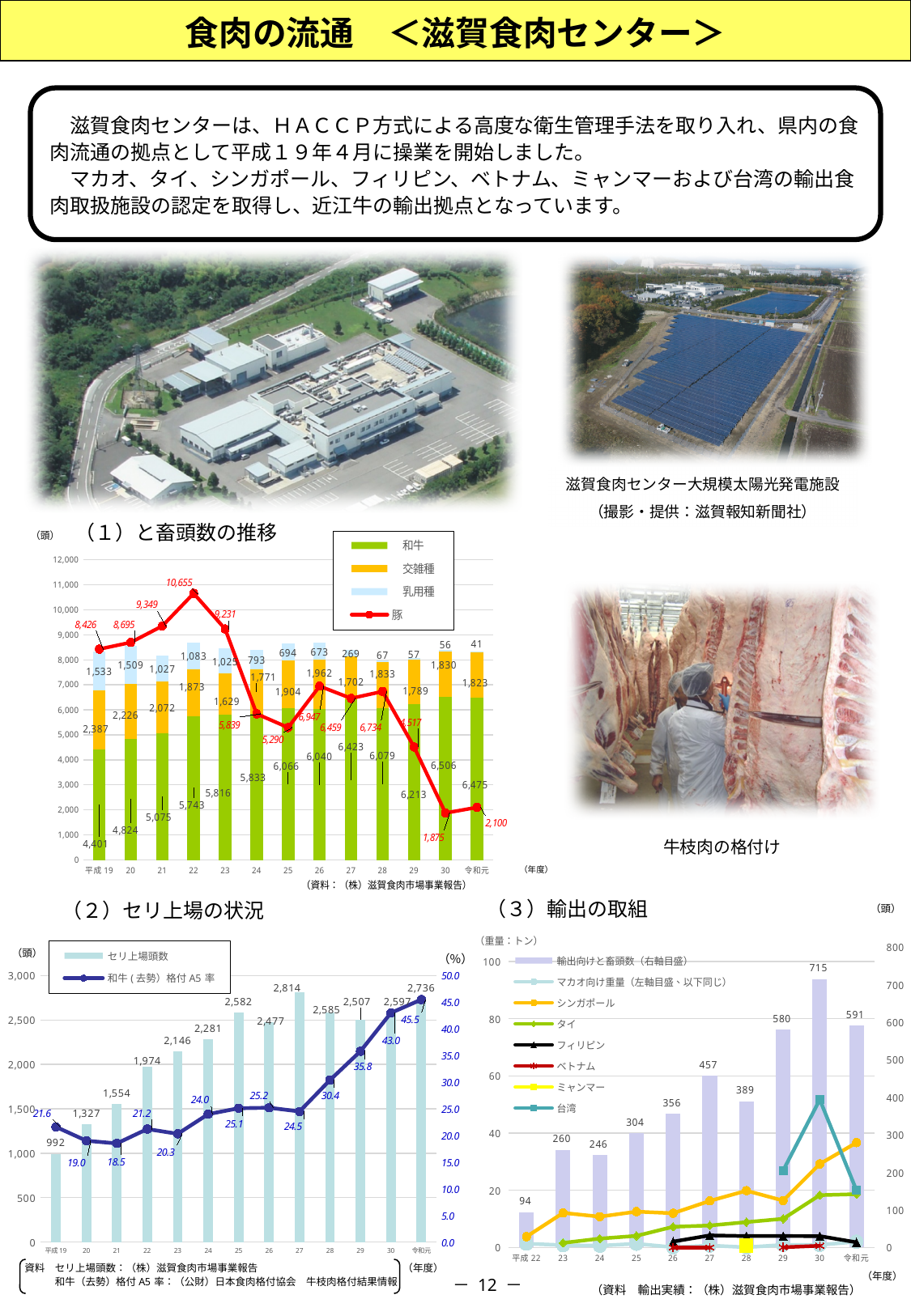
In the chart titled （２）セリ上場の状況, what is the セリ上場頭数 value for 平成27? 2,814 In the chart titled （１）と畜頭数の推移, what is the total of the stacked bar for 平成19 (和牛 + 交雑種 + 乳用種)? 8,321 In the chart titled （１）と畜頭数の推移, in which year is the 豚 line at its highest? 平成22 In the chart titled （２）セリ上場の状況, what is the 和牛(去勢)格付A5率 value for 令和元? 45.5 In the chart titled （３）輸出の取組, what is the 輸出向けと畜頭数 value for 平成30? 715 In the chart titled （３）輸出の取組, how many years are shown on the x axis? 10 In the chart titled （１）と畜頭数の推移, how many series does the legend list? 4 In the chart titled （１）と畜頭数の推移, what is the 豚 value for 平成22? 10,655 In the chart titled （１）と畜頭数の推移, what is the 和牛 value for 令和元? 6,475 In the chart titled （１）と畜頭数の推移, in which year is the 乳用種 value lowest? 令和元 In the chart titled （２）セリ上場の状況, does the 和牛(去勢)格付A5率 line generally rise or fall from 平成24 to 令和元? rise In the chart titled （２）セリ上場の状況, what is the difference between the セリ上場頭数 values for 令和元 and 平成19? 1,744